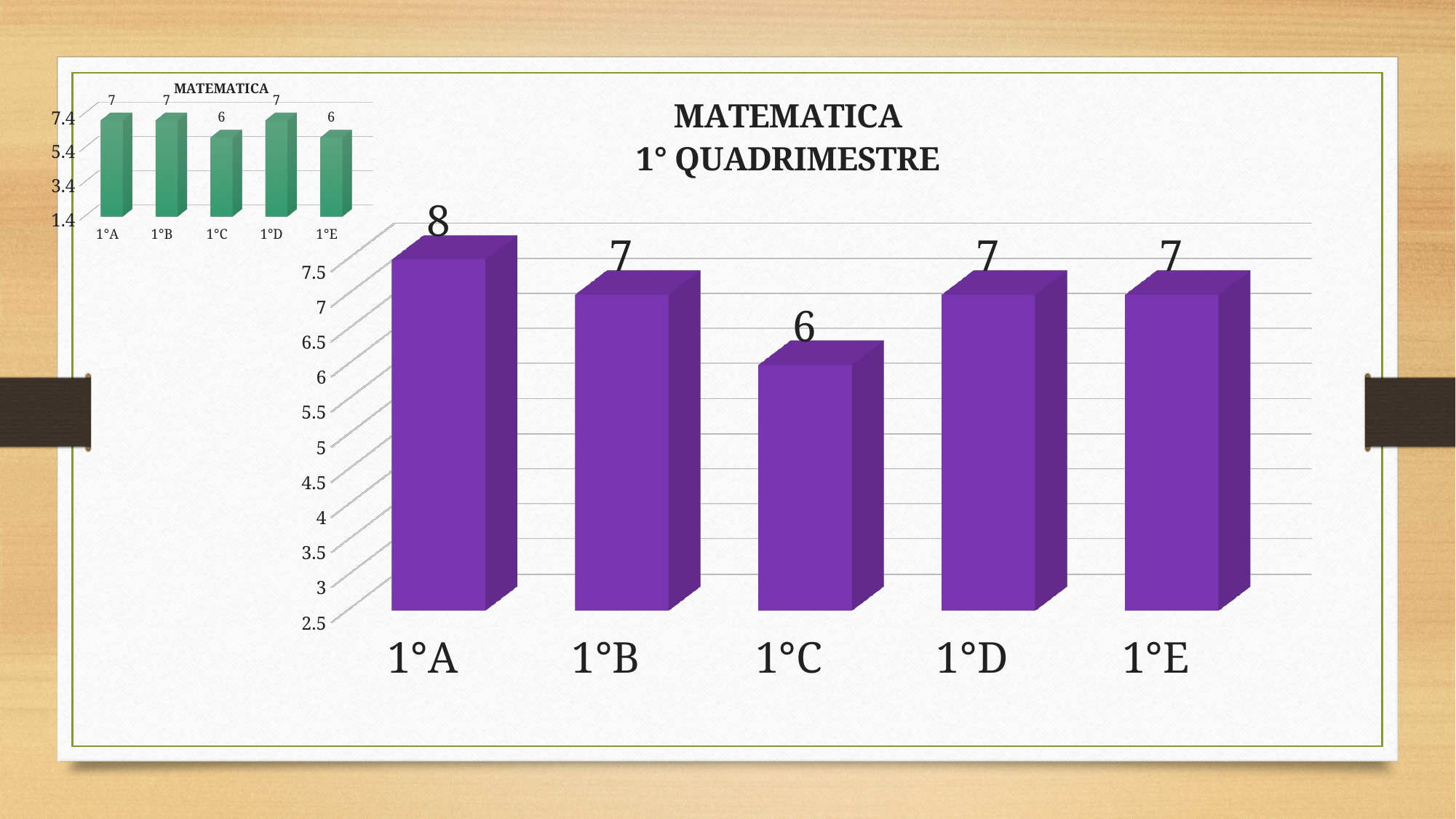
In the large chart titled 'MATEMATICA 1° QUADRIMESTRE', what is the difference between the values for 1°A and 1°C? 2 In the large chart titled 'MATEMATICA 1° QUADRIMESTRE', which category has the highest value? 1°A What kind of chart is the large chart titled 'MATEMATICA 1° QUADRIMESTRE'? bar chart In the small chart at the top left titled 'MATEMATICA', what is the difference between the values for 1°D and 1°C? 1 In the small chart at the top left titled 'MATEMATICA', what is the value for 1°E? 6 In the large chart titled 'MATEMATICA 1° QUADRIMESTRE', which category has the lowest value? 1°C In the small chart at the top left titled 'MATEMATICA', what is the value for 1°A? 7 In the large chart titled 'MATEMATICA 1° QUADRIMESTRE', how many categories are shown? 5 In the large chart titled 'MATEMATICA 1° QUADRIMESTRE', which is larger, the value for 1°B or the value for 1°C? 1°B In the large chart titled 'MATEMATICA 1° QUADRIMESTRE', what is the value for 1°C? 6 What colour are the bars in the large chart titled 'MATEMATICA 1° QUADRIMESTRE'? purple In the large chart titled 'MATEMATICA 1° QUADRIMESTRE', what is the value for 1°A? 8